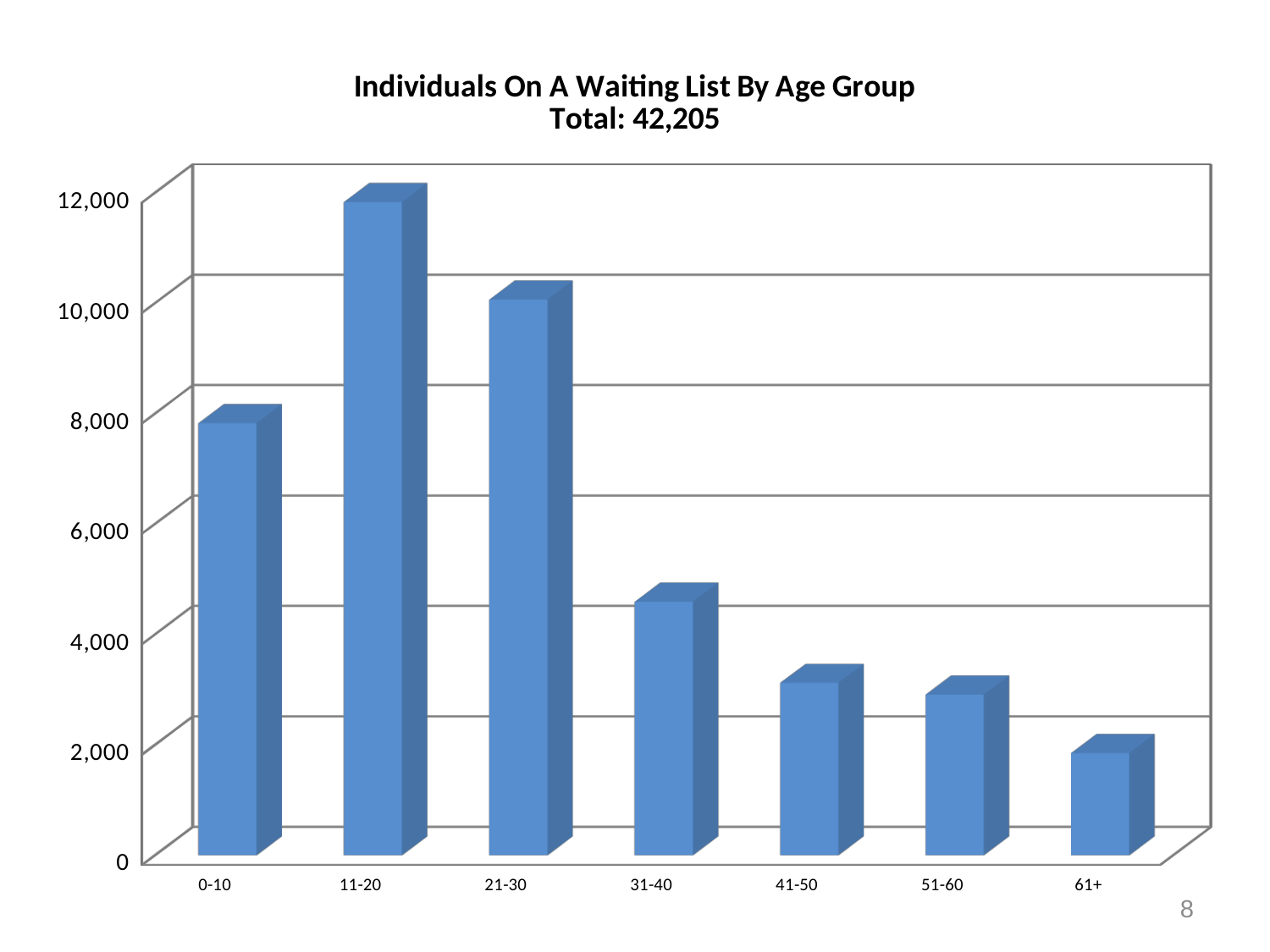
Which age group has more individuals on the waiting list, 21-30 or 31-40? 21-30 Is the value for the 61+ age group greater or less than 4,000? less How many age groups are shown on the x axis? 7 What kind of chart is shown on the slide? bar chart Which age group has the highest number of individuals on the waiting list? 11-20 What total number of individuals is stated in the chart title? 42,205 Which age group has the lowest number of individuals on the waiting list? 61+ From the 11-20 age group onward, do the values rise or fall as age increases? fall Is the value for the 31-40 age group greater or less than 6,000? less Is the value for the 11-20 age group greater or less than 10,000? greater